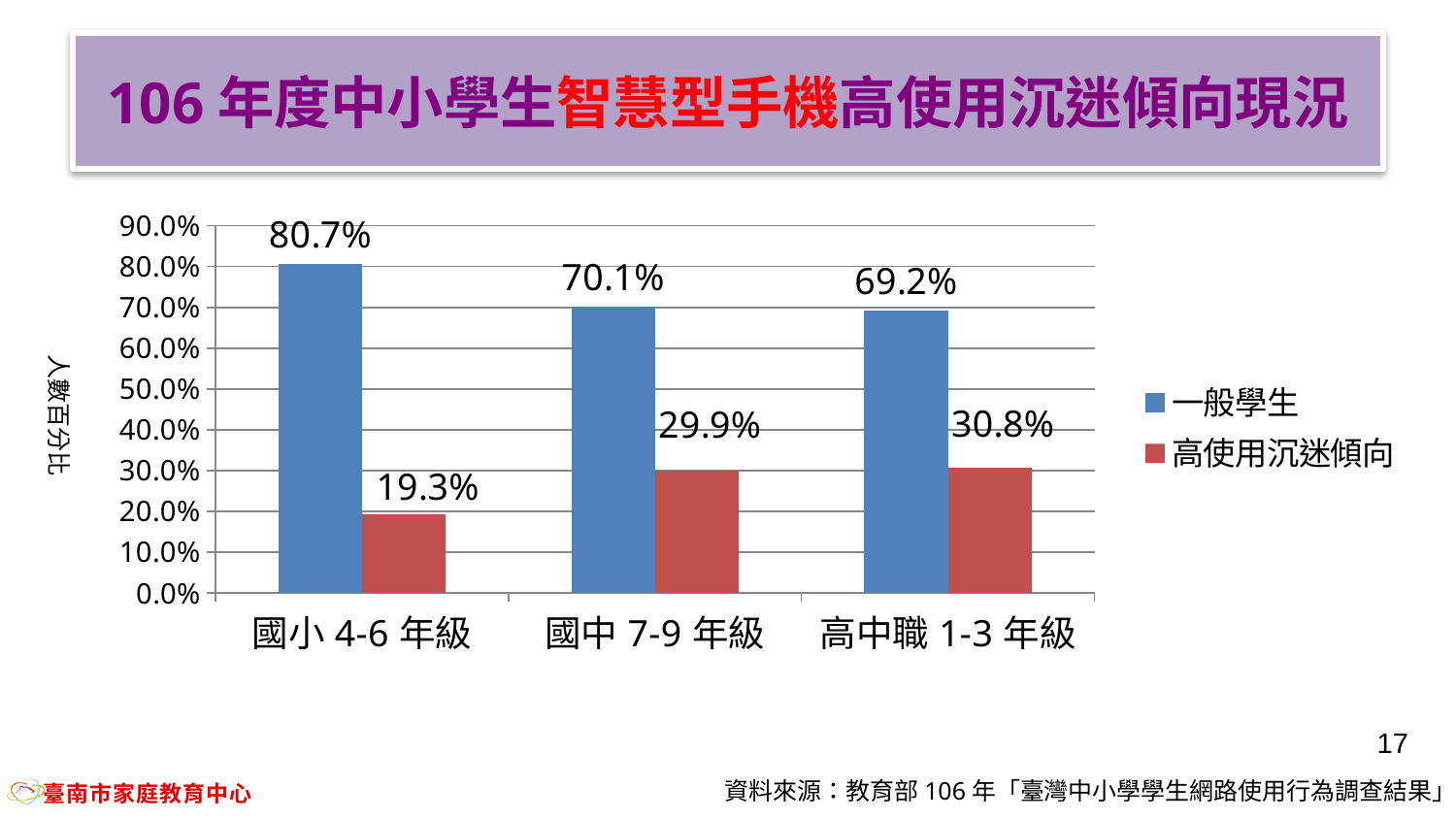
Which category has the highest value for 一般學生? 國小 4-6 年級 Is the value for 一般學生 in 高中職 1-3 年級 greater or less than 60.0%? greater Does the value for 一般學生 rise or fall from 國小 4-6 年級 to 高中職 1-3 年級? fall What kind of chart is shown on the slide? bar chart What is the value for 一般學生 in 國小 4-6 年級? 80.7% What is the value for 高使用沉迷傾向 in 高中職 1-3 年級? 30.8% How many series does the legend list? 2 What is the difference between 一般學生 and 高使用沉迷傾向 in 國小 4-6 年級? 61.4% How many categories are shown on the x axis? 3 What is the value for 高使用沉迷傾向 in 國中 7-9 年級? 29.9% Which is larger: 高使用沉迷傾向 in 國中 7-9 年級 or in 國小 4-6 年級? 國中 7-9 年級 Which category has the lowest value for 高使用沉迷傾向? 國小 4-6 年級